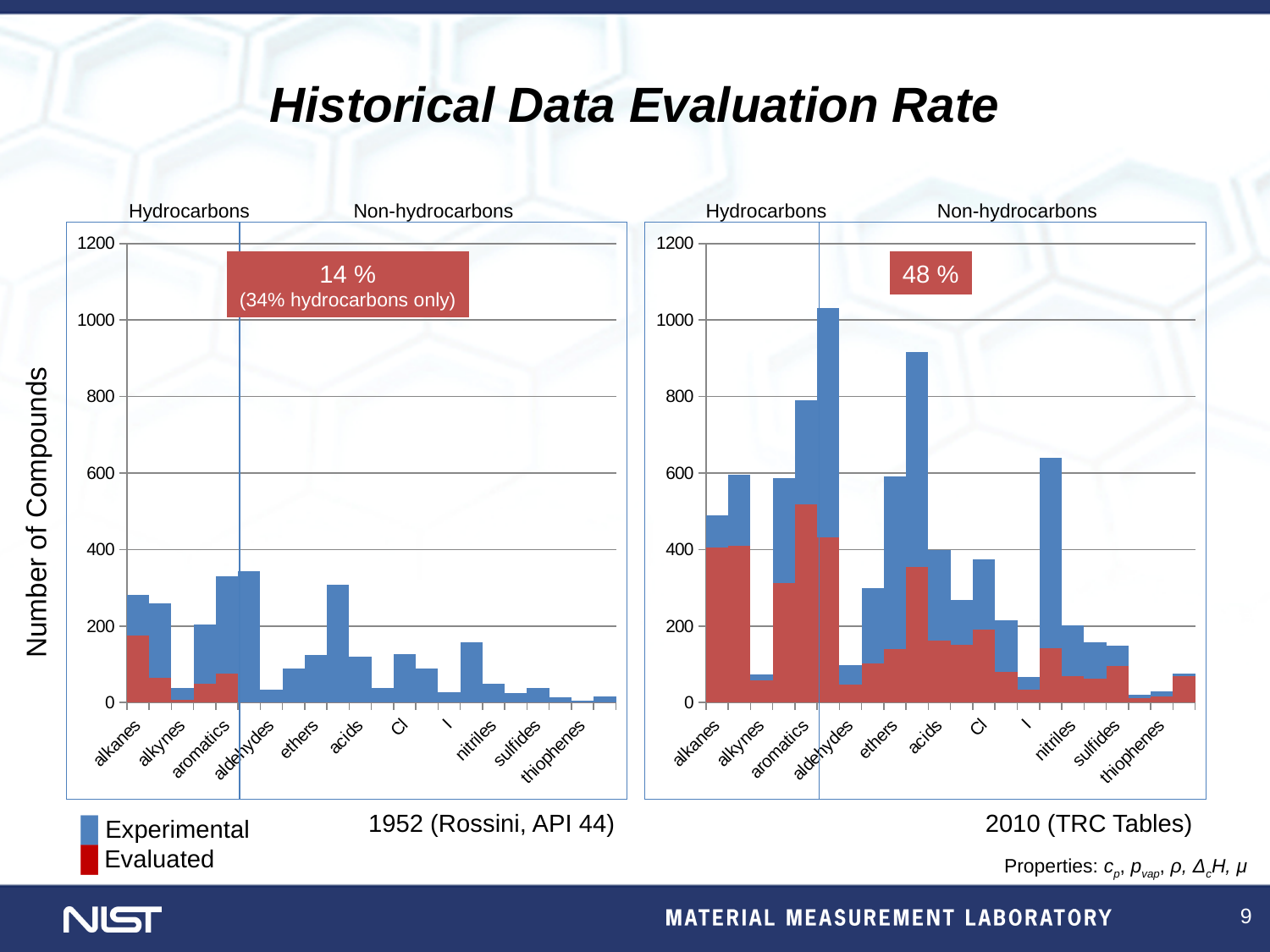
On the 2010 (TRC Tables) chart, is the Experimental value for alkanes larger than the Evaluated value for alkanes? No On the 1952 (Rossini, API 44) chart, what percentage is given for hydrocarbons only? 34% What evaluation percentage is printed on the 1952 (Rossini, API 44) chart? 14 % Which chart has the taller tallest bar, the 1952 (Rossini, API 44) chart or the 2010 (TRC Tables) chart? 2010 (TRC Tables) What is the title of the slide containing the two charts? Historical Data Evaluation Rate How many series does the legend list for the charts? 2 What evaluation percentage is printed on the 2010 (TRC Tables) chart? 48 % What kind of chart is the 1952 (Rossini, API 44) chart? bar chart Which series is shown in red in the charts? Evaluated On the 1952 (Rossini, API 44) chart, is the Experimental value for ethers greater or less than 200? less